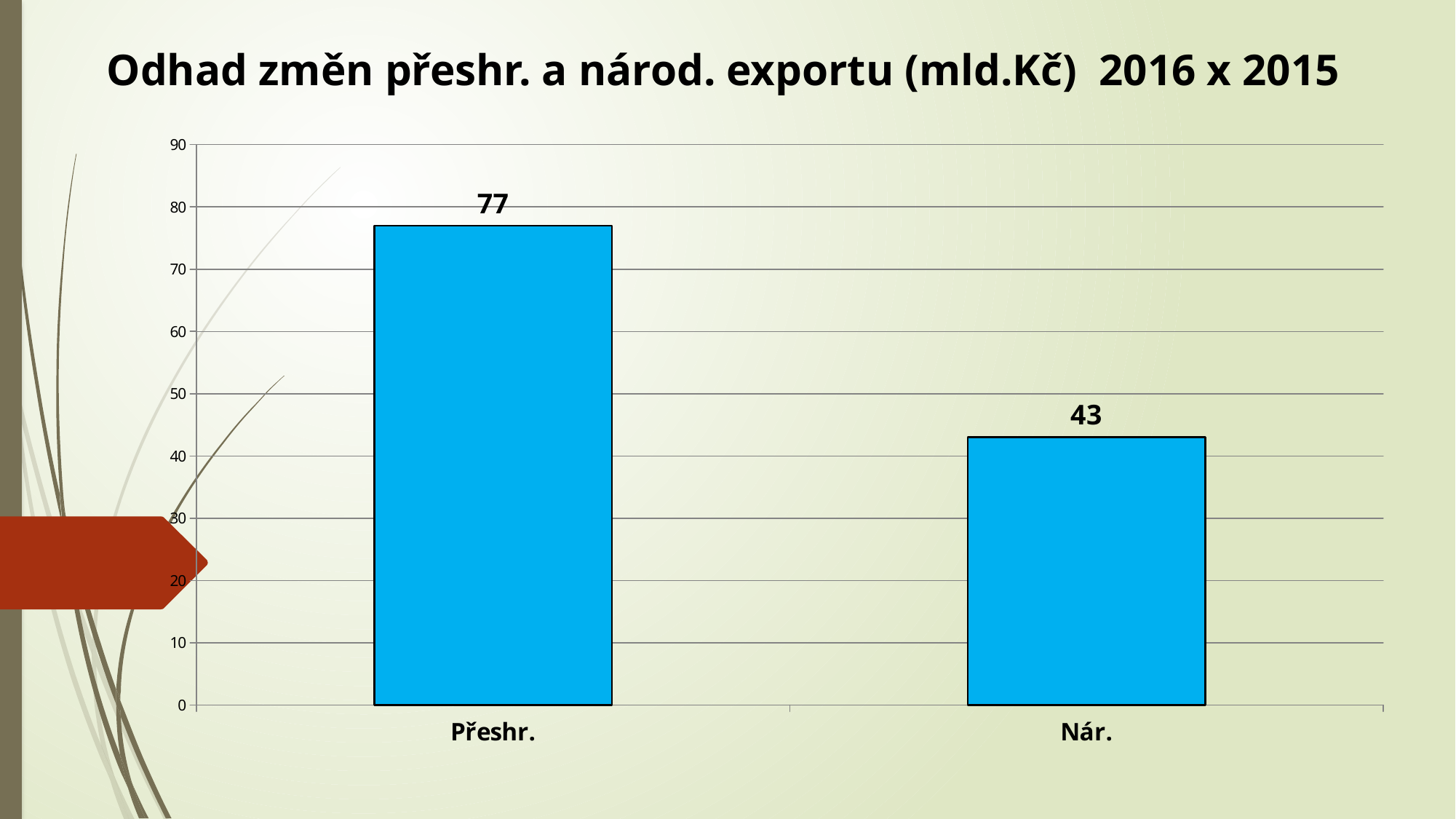
Is the value for Nár. greater or less than 50? less What is the value for Nár.? 43 Which is larger, the value for Přeshr. or the value for Nár.? Přeshr. Which category has the lowest value? Nár. Which category has the highest value? Přeshr. What kind of chart is shown on the slide? bar chart How many categories are shown on the x axis? 2 What is the value for Přeshr.? 77 What is the highest value shown on the y axis? 90 Is the value for Přeshr. greater or less than 70? greater What is the difference between the values for Přeshr. and Nár.? 34 What is the title of the slide? Odhad změn přeshr. a národ. exportu (mld.Kč) 2016 x 2015